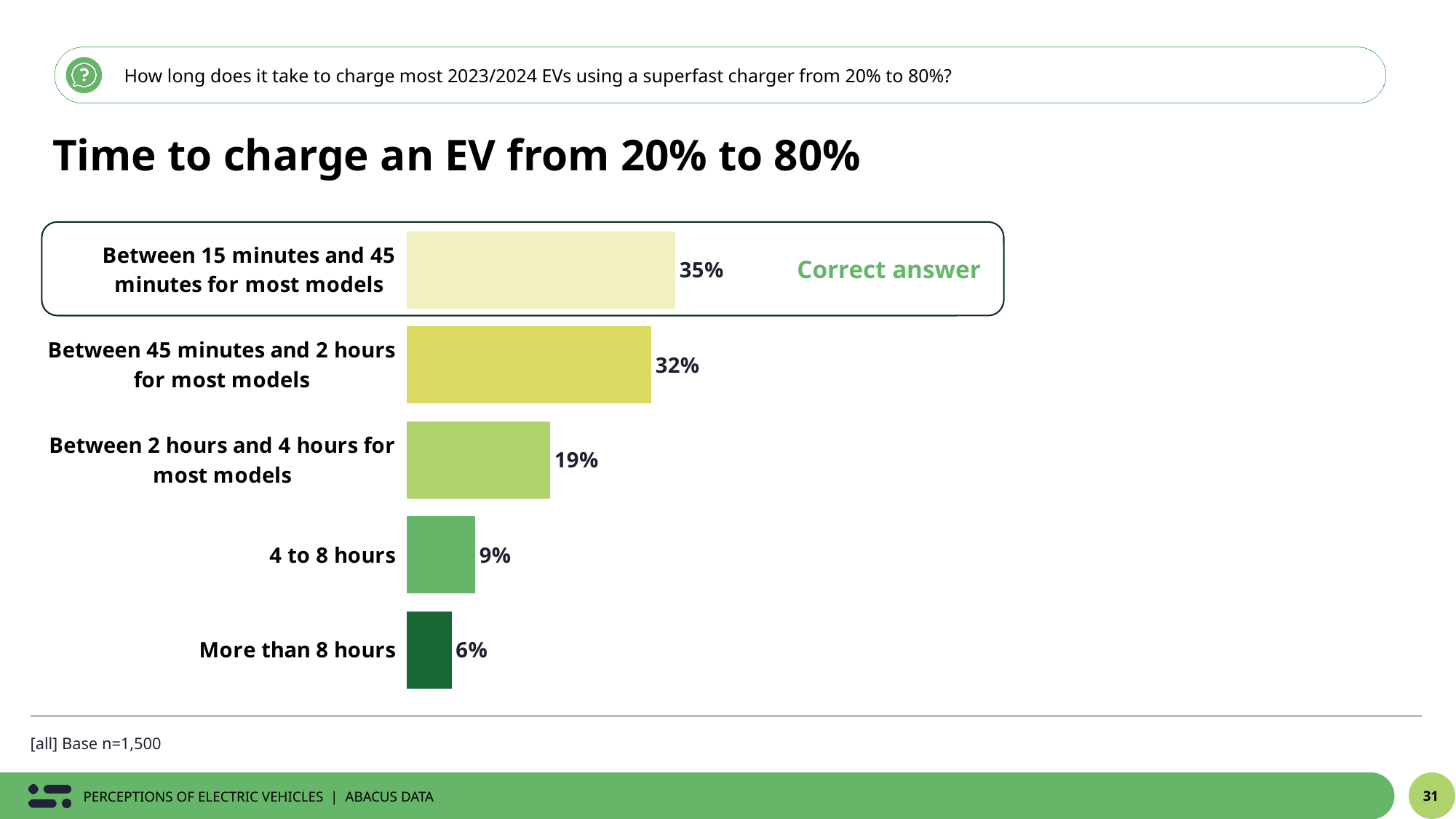
Which category has the lowest value? More than 8 hours Which is larger: the value for 'Between 2 hours and 4 hours for most models' or for '4 to 8 hours'? Between 2 hours and 4 hours for most models Which category is marked as the correct answer? Between 15 minutes and 45 minutes for most models What is the value for 'Between 45 minutes and 2 hours for most models'? 32% What kind of chart is shown on the slide? Bar chart What is the difference between the values for 'Between 15 minutes and 45 minutes for most models' and 'Between 45 minutes and 2 hours for most models'? 3% How many categories are shown in the chart? 5 What percentage chose 'More than 8 hours'? 6% What is the difference between the values for 'Between 2 hours and 4 hours for most models' and '4 to 8 hours'? 10% What is the value for '4 to 8 hours'? 9% Which category has the highest value? Between 15 minutes and 45 minutes for most models What percentage of respondents chose 'Between 15 minutes and 45 minutes for most models'? 35%